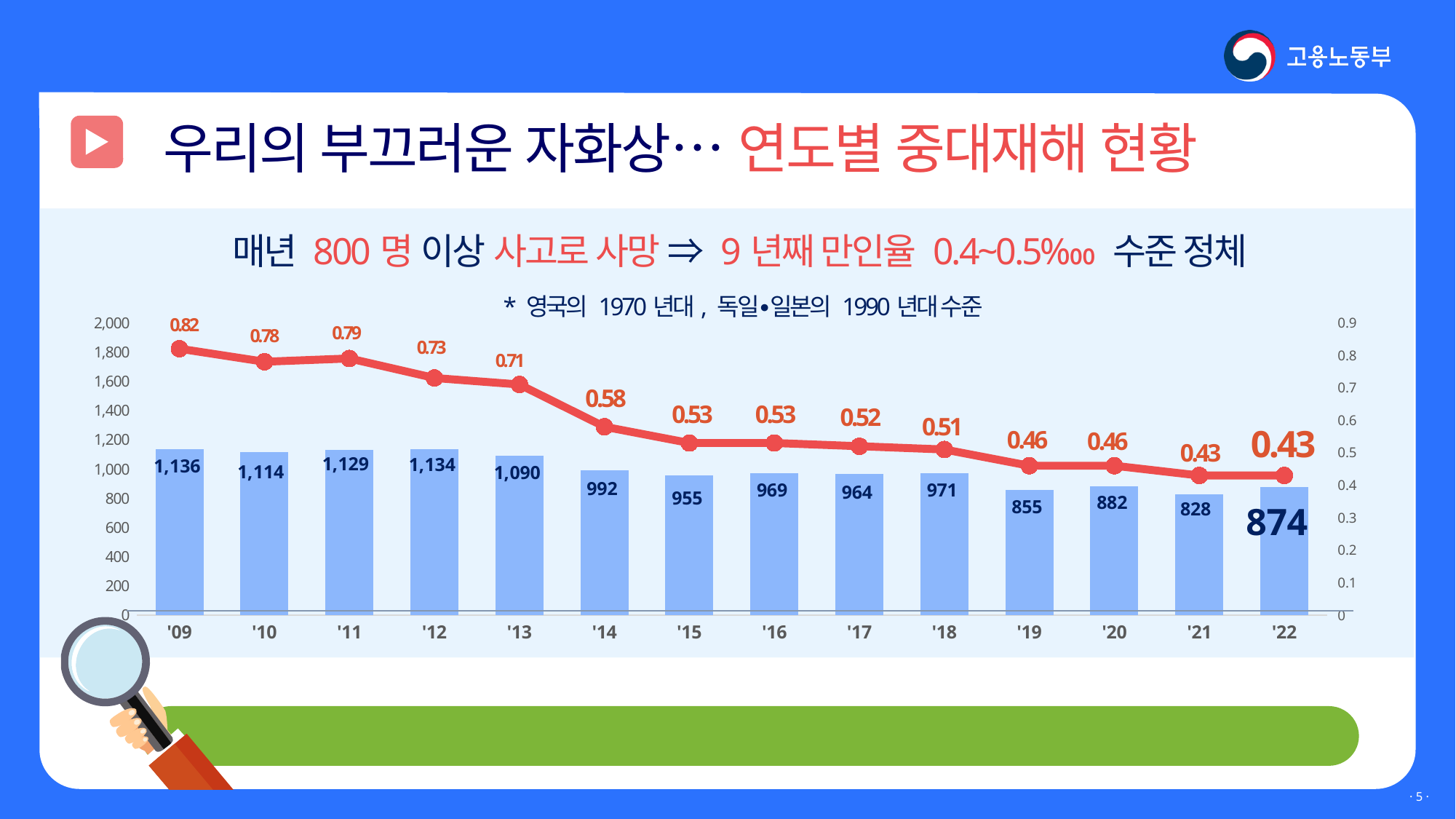
What is the line value (rate) for '09? 0.82 Which year has the lowest bar value? '21 What is the bar value for '22? 874 What kind of chart is this? Combined bar and line chart What is the bar value for '13? 1,090 Which year has the highest bar value? '09 What is the difference between the line values for '09 and '22? 0.39 What is the difference between the bar values for '09 and '22? 262 How many years are shown on the x axis? 14 What is the line value (rate) for '14? 0.58 Does the red line rise or fall from '09 to '22? Fall Which has a larger bar value, '19 or '20? '20